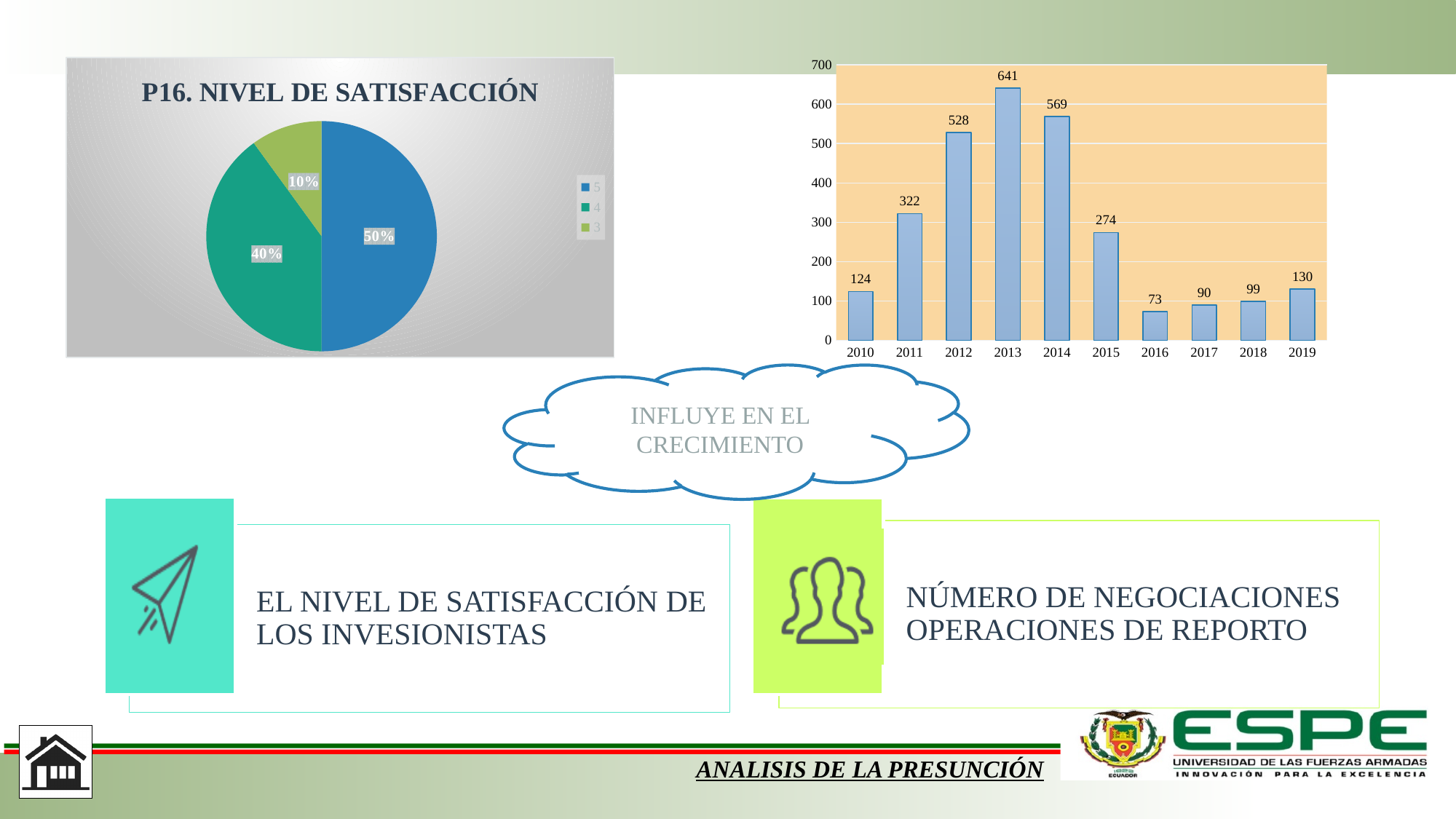
What kind of chart is the chart on the right? bar chart In the bar chart on the right, which year has the lowest value? 2016 In the bar chart on the right, which is larger, the value for 2011 or the value for 2015? 2011 In the bar chart on the right, what is the value for 2013? 641 In the bar chart on the right, what is the value for 2016? 73 In the bar chart on the right, which year has the highest value? 2013 How many entries does the legend of the pie chart 'P16. NIVEL DE SATISFACCIÓN' list? 3 In the pie chart 'P16. NIVEL DE SATISFACCIÓN', which category has the smallest slice? 3 In the pie chart 'P16. NIVEL DE SATISFACCIÓN', what share does category 5 have? 50% In the bar chart on the right, what is the difference between the values for 2013 and 2014? 72 In the bar chart on the right, do the values rise or fall from 2016 to 2019? rise In the bar chart on the right, how many years are shown on the x axis? 10